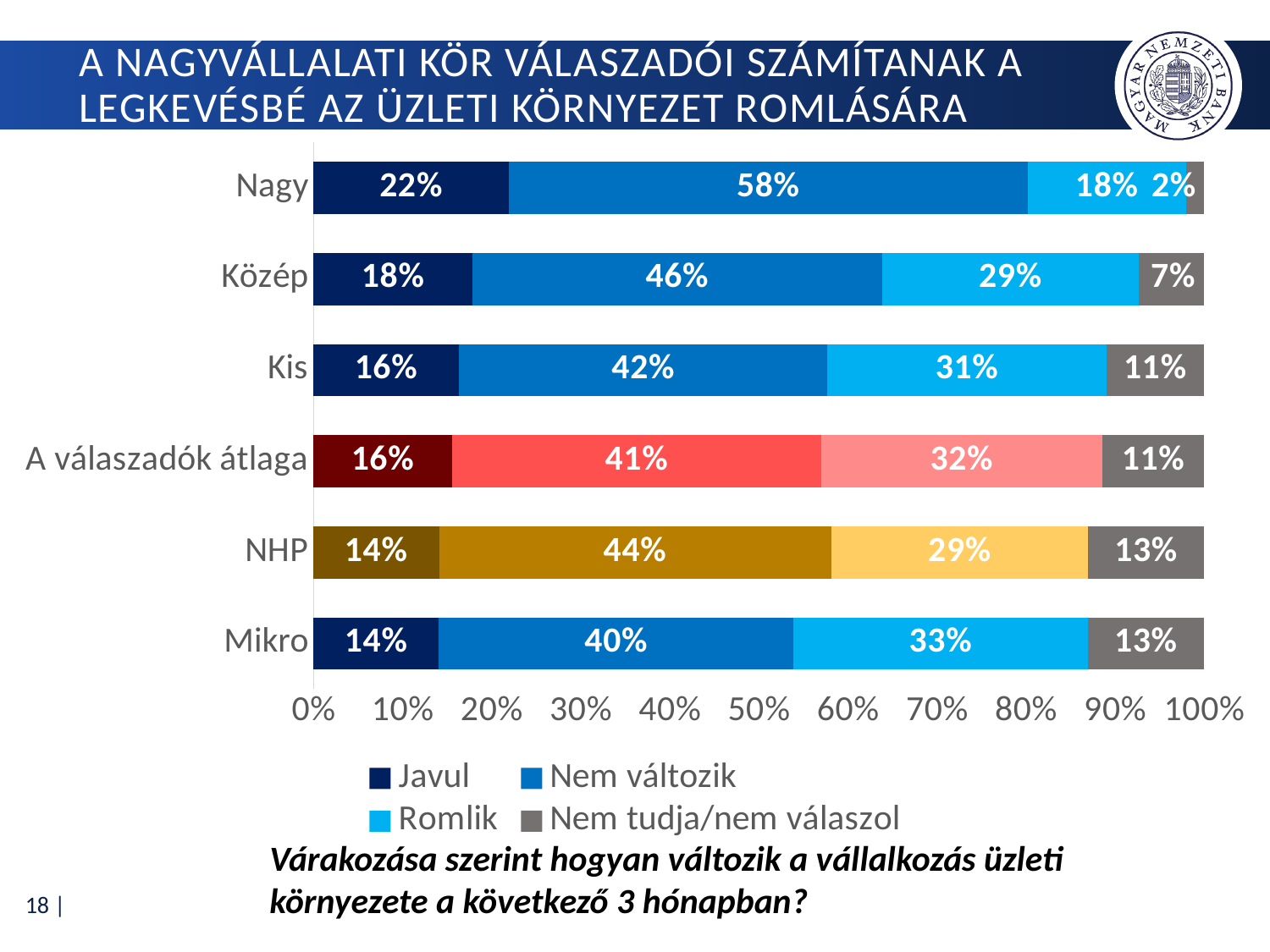
Which category has the lowest 'Nem tudja/nem válaszol' value? Nagy What is the total of the 'Javul' and 'Nem változik' segments for the 'NHP' category? 58% Which is larger: the 'Nem változik' value for 'Közép' or for 'Kis'? Közép What kind of chart is shown on the slide? Stacked bar chart How many categories are shown on the vertical axis of the chart? 6 Which series is shown in the legend immediately after 'Javul'? Nem változik Which category has the highest 'Javul' value? Nagy What is the difference between the 'Romlik' values for 'Mikro' and 'Nagy'? 15% What is the 'Romlik' value for the 'Mikro' category? 33% How many series does the legend list? 4 What is the 'Nem tudja/nem válaszol' value for the 'Közép' category? 7% What is the 'Nem változik' value for the 'Nagy' category? 58%